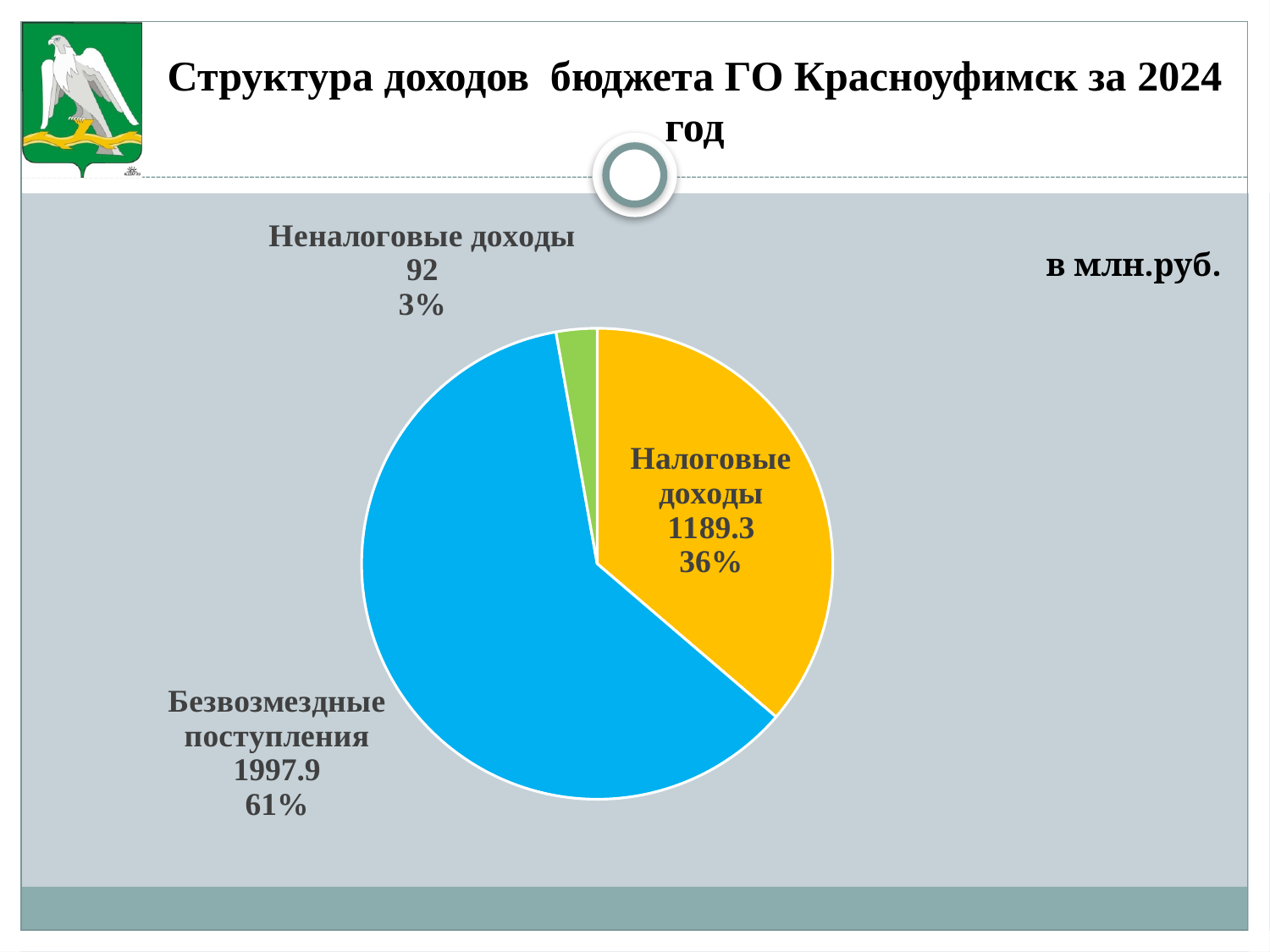
How many categories does the pie chart have? 3 What is the value for Налоговые доходы? 1189.3 What share of the pie does Налоговые доходы represent? 36% In what units are the values on the chart given? млн.руб. What share of the pie does Неналоговые доходы represent? 3% What is the value for Неналоговые доходы? 92 Which category has the largest value? Безвозмездные поступления What type of chart is shown on the slide? pie chart What is the value for Безвозмездные поступления? 1997.9 What is the difference between Безвозмездные поступления and Налоговые доходы? 808.6 Which category has the smallest value? Неналоговые доходы What share of the pie does Безвозмездные поступления represent? 61%